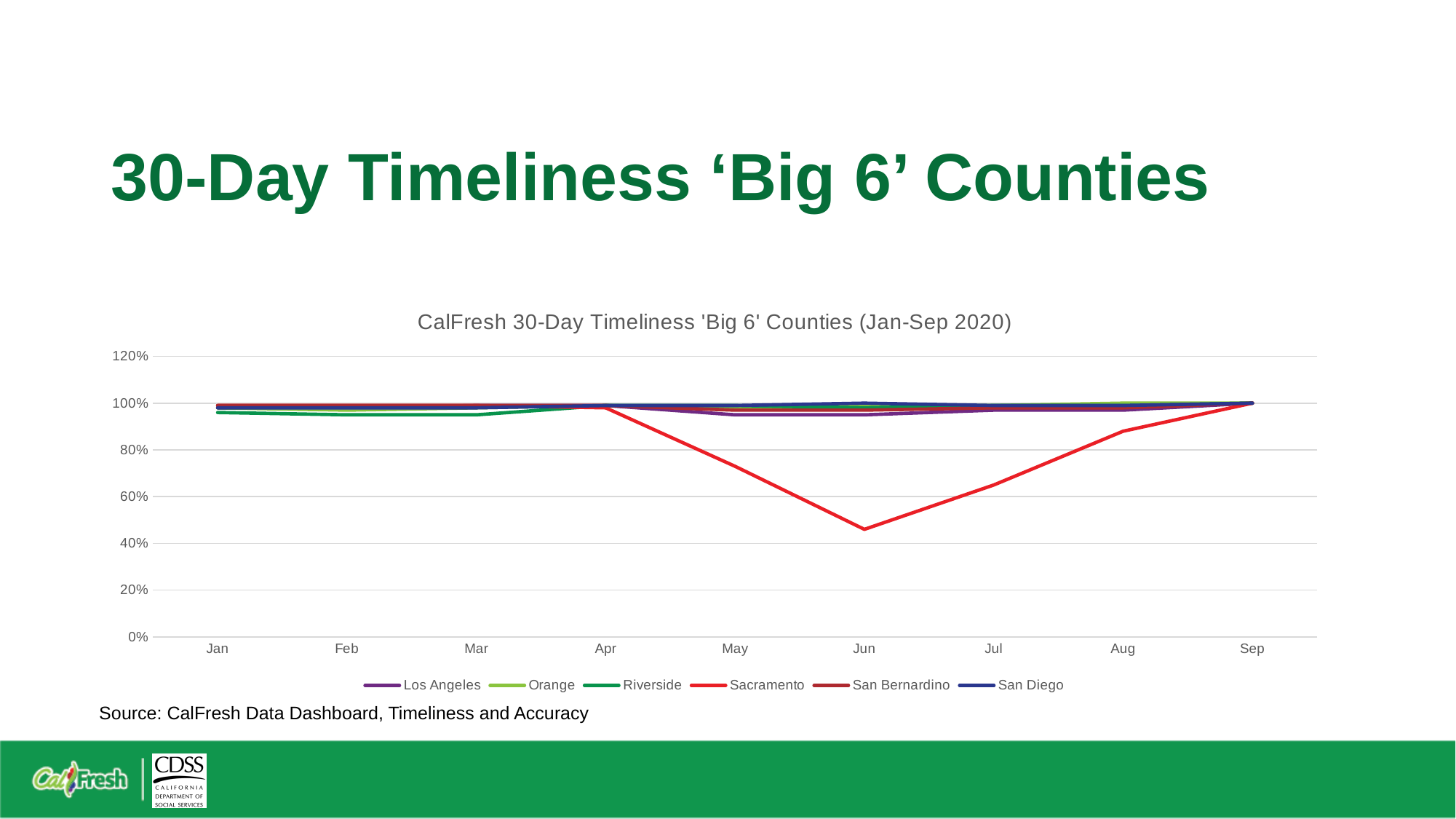
Is the value for Los Angeles in Jan greater or less than 80%? greater What type of chart is shown on the slide? line chart How many months are plotted along the x axis? 9 Which county is shown with a red line in the legend? Sacramento What is the title of the chart? CalFresh 30-Day Timeliness 'Big 6' Counties (Jan-Sep 2020) Does the Sacramento line rise or fall from Apr to Jun? fall How many series does the legend list? 6 Is the value for Sacramento in Jun greater or less than 60%? less Is the value for Sacramento in Aug greater or less than 80%? greater Which is larger in Jun: the value for Sacramento or the value for Riverside? Riverside Which county has the lowest 30-day timeliness in Jun? Sacramento